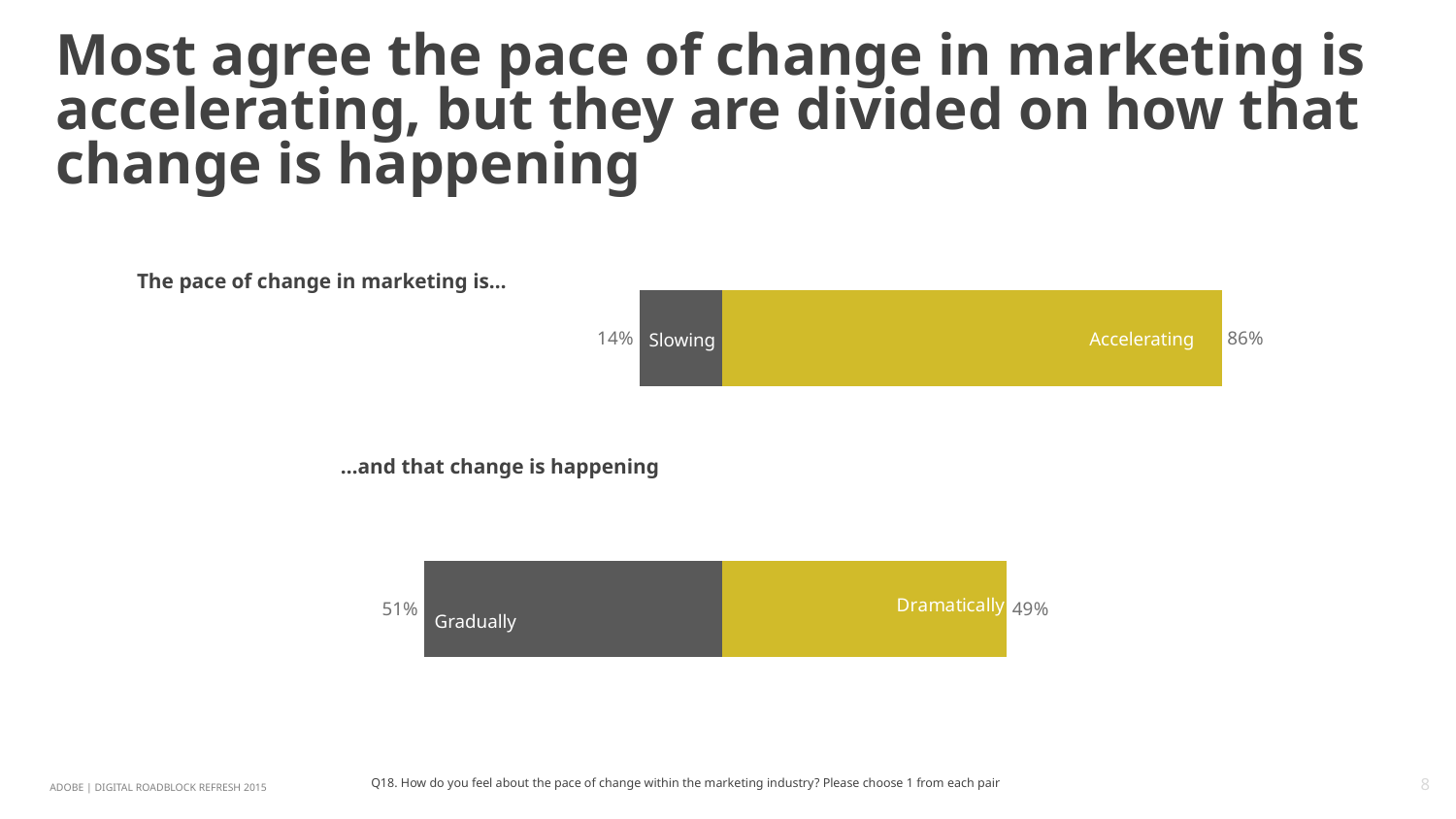
In the chart titled "The pace of change in marketing is...", which response has the higher percentage? Accelerating In the chart titled "The pace of change in marketing is...", what colour is the Accelerating bar? Yellow In the chart titled "The pace of change in marketing is...", which response has the lower percentage? Slowing What kind of chart is used on this slide to show the pace of change in marketing? Bar chart In the chart titled "The pace of change in marketing is...", what percentage chose Slowing? 14% In the chart titled "...and that change is happening", what percentage chose Gradually? 51% How many response categories are shown in the chart titled "...and that change is happening"? 2 In the chart titled "...and that change is happening", what is the difference in percentage points between Gradually and Dramatically? 2 In the chart titled "The pace of change in marketing is...", what percentage chose Accelerating? 86% In the chart titled "The pace of change in marketing is...", what is the difference in percentage points between Accelerating and Slowing? 72 In the chart titled "...and that change is happening", what do the Gradually and Dramatically percentages add up to? 100% In the chart titled "...and that change is happening", what percentage chose Dramatically? 49%